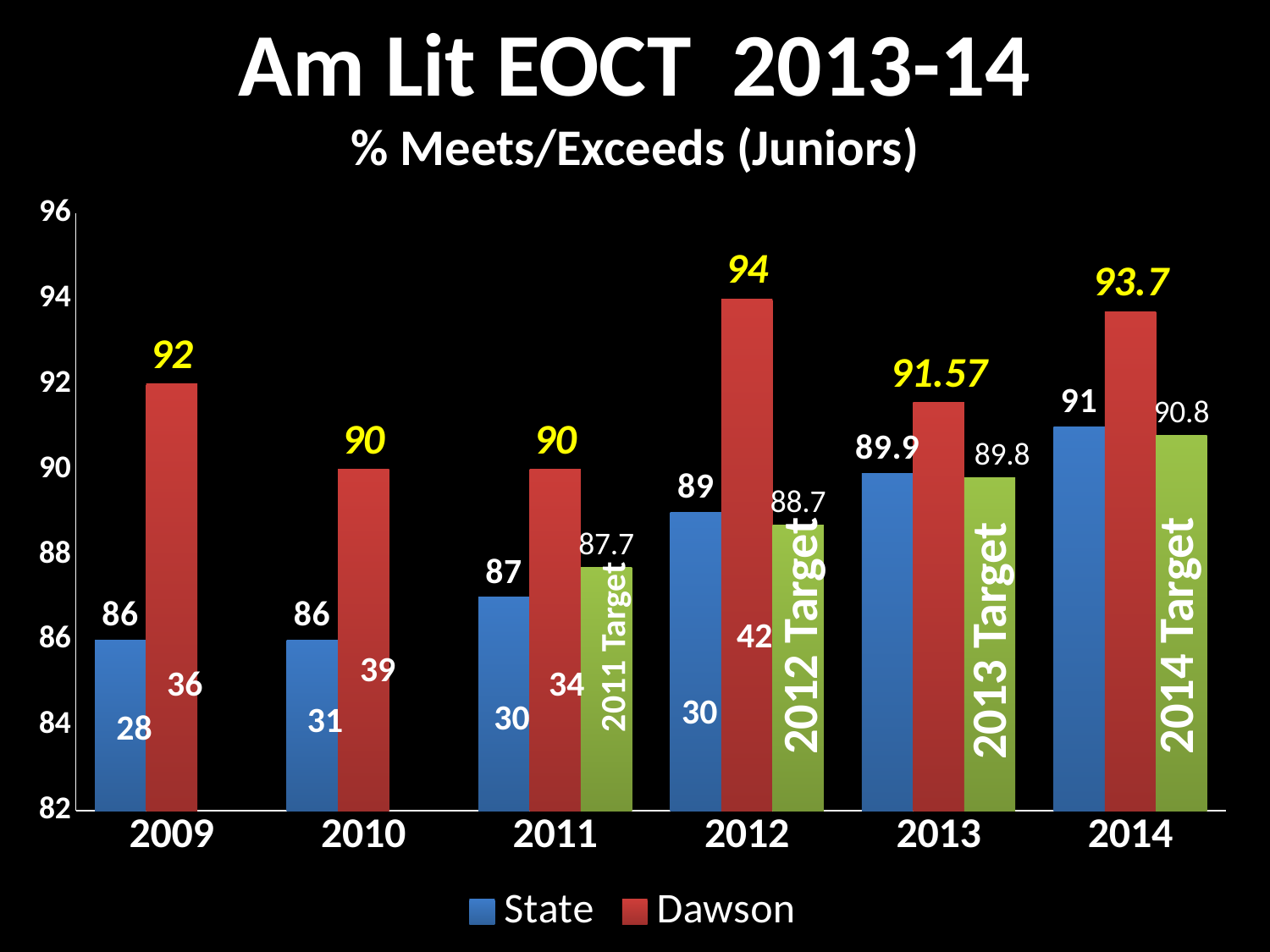
How many series does the legend list? 2 What is the Dawson value for 2012? 94 In which year is the Dawson value highest? 2012 In which year is the State value highest? 2014 How many years are shown on the x axis? 6 What is the difference between the Dawson and State values in 2009? 6 Is the Dawson value for 2014 greater or less than 92? greater What kind of chart is shown on the slide? bar chart Do the State values rise or fall from 2009 to 2014? rise What is the State value for 2013? 89.9 What is the value of the 2014 Target bar? 90.8 In 2013, which is larger, the State value or the Dawson value? Dawson